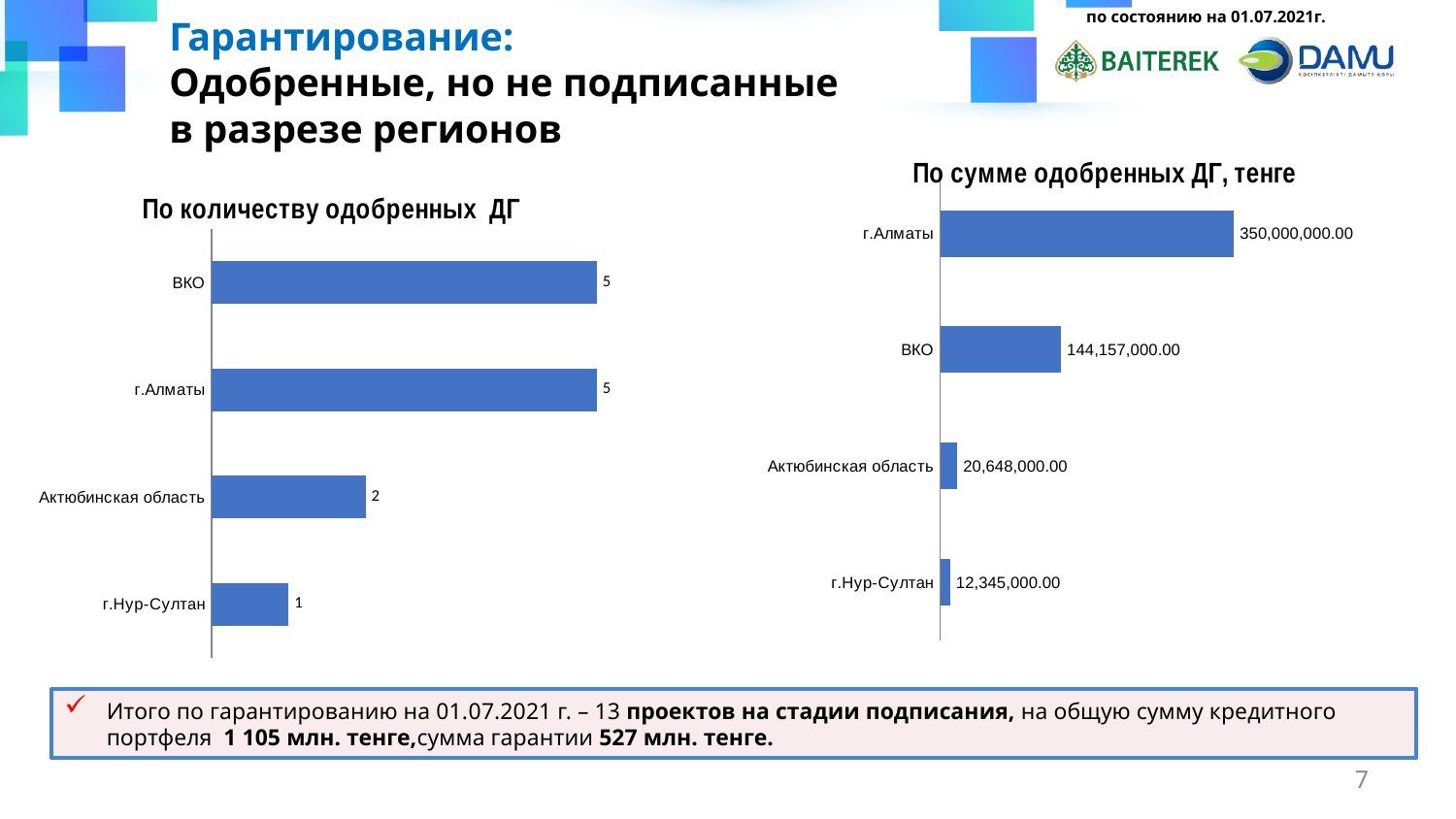
In the chart 'По сумме одобренных ДГ, тенге', what is the value for г.Алматы? 350,000,000.00 What type of chart is 'По сумме одобренных ДГ, тенге'? Bar chart In the chart 'По количеству одобренных ДГ', how many regions are shown? 4 In the chart 'По сумме одобренных ДГ, тенге', what is the difference between the values for г.Алматы and ВКО? 205,843,000.00 In the chart 'По сумме одобренных ДГ, тенге', what is the value for г.Нур-Султан? 12,345,000.00 In the chart 'По количеству одобренных ДГ', which region has the lowest value? г.Нур-Султан In the chart 'По сумме одобренных ДГ, тенге', which is larger: the value for Актюбинская область or the value for г.Нур-Султан? Актюбинская область In the chart 'По количеству одобренных ДГ', what is the value for Актюбинская область? 2 In the chart 'По сумме одобренных ДГ, тенге', which region has the highest value? г.Алматы In the chart 'По количеству одобренных ДГ', what is the difference between the values for ВКО and Актюбинская область? 3 In the chart 'По сумме одобренных ДГ, тенге', what is the value for ВКО? 144,157,000.00 In the chart 'По количеству одобренных ДГ', what is the value for г.Нур-Султан? 1